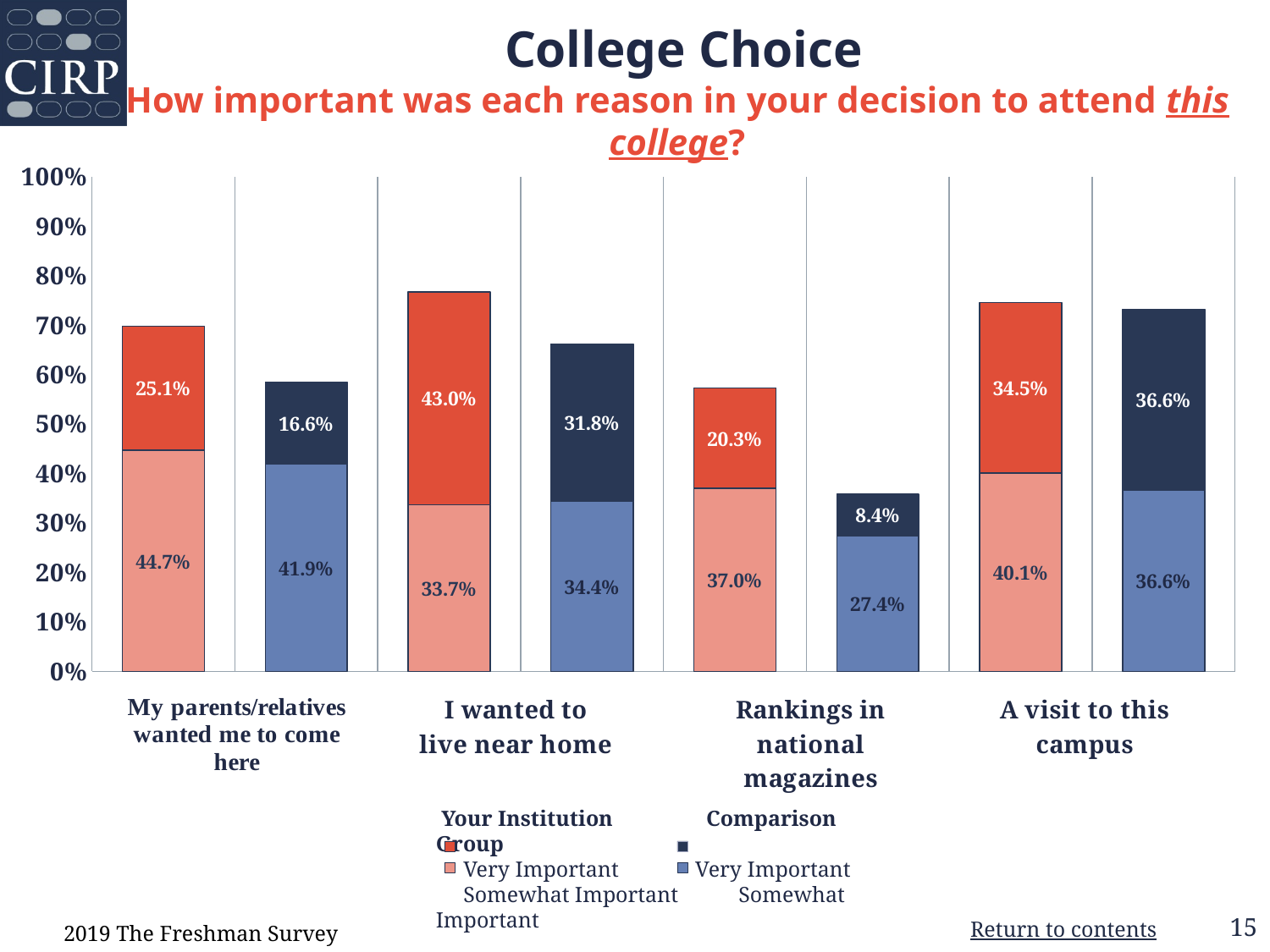
How many entries does the legend list? 4 How many reasons (categories) are shown along the x axis? 4 What is the total stacked value (Very Important plus Somewhat Important) for the Comparison Group on 'Rankings in national magazines'? 35.8% What is the total stacked value (Very Important plus Somewhat Important) for Your Institution on 'A visit to this campus'? 74.6% What percentage of Your Institution students rated 'I wanted to live near home' as Very Important? 43.0% What kind of chart is shown on the slide? stacked bar chart What percentage of Your Institution students rated 'My parents/relatives wanted me to come here' as Somewhat Important? 44.7% What percentage of the Comparison Group rated 'Rankings in national magazines' as Very Important? 8.4% What is the difference between the Your Institution and Comparison Group Very Important values for 'I wanted to live near home'? 11.2% Which is larger: the Your Institution Somewhat Important value for 'Rankings in national magazines' or the Comparison Group Somewhat Important value for the same reason? Your Institution (37.0%) Which reason has the highest Your Institution Very Important value? I wanted to live near home Which reason has the lowest Comparison Group Very Important value? Rankings in national magazines